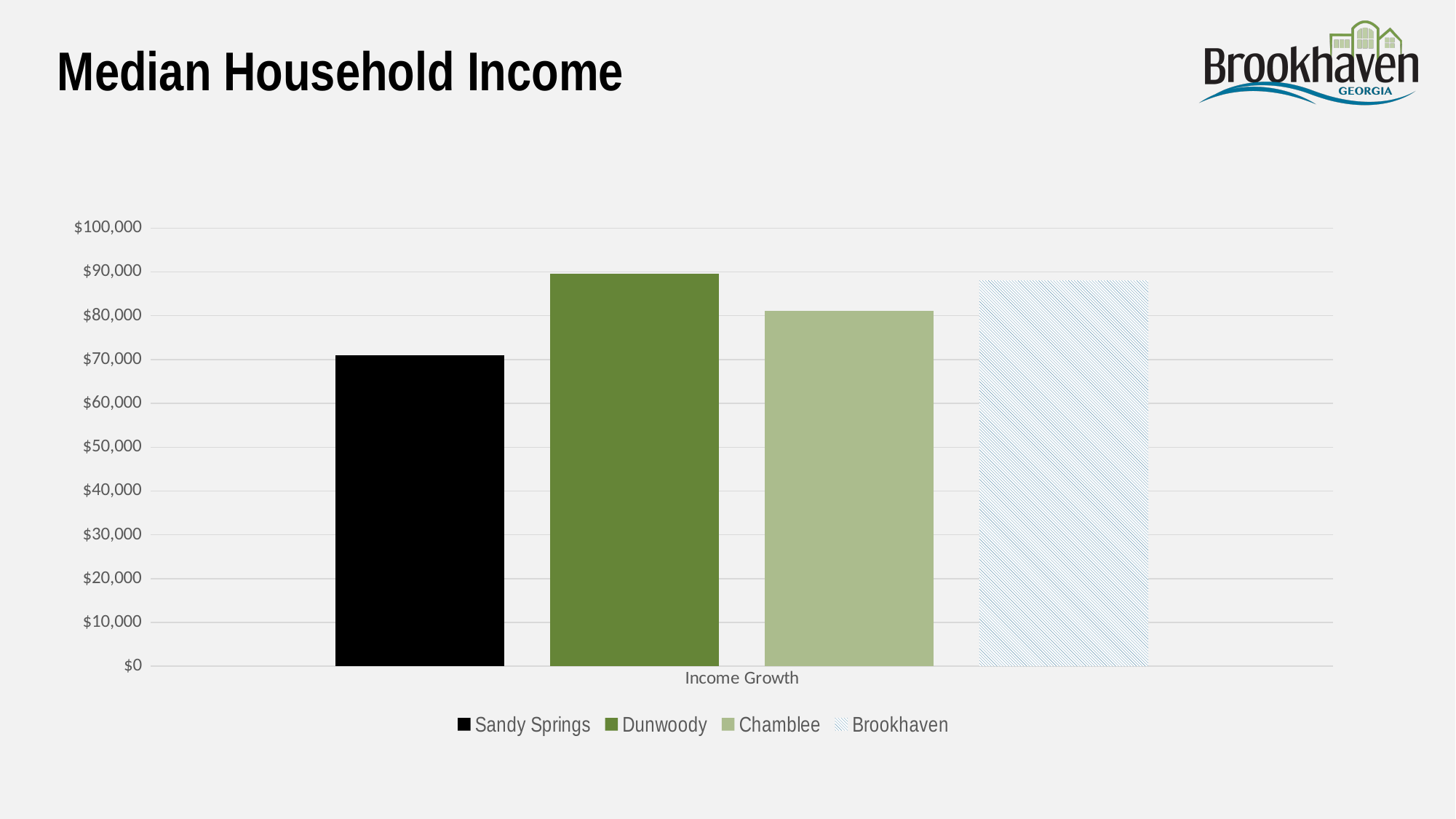
Which is larger, the value for Chamblee or the value for Brookhaven? Brookhaven Which is larger, the value for Brookhaven or the value for Sandy Springs? Brookhaven Which series has the lowest median household income? Sandy Springs Is the value for Dunwoody greater or less than $80,000? greater Is the value for Chamblee greater or less than $90,000? less What kind of chart is shown on the slide? bar chart Which is larger, the value for Dunwoody or the value for Chamblee? Dunwoody Is the value for Sandy Springs greater or less than $80,000? less What is the title of the chart? Median Household Income How many series does the legend list? 4 What is the label shown on the x axis below the bars? Income Growth